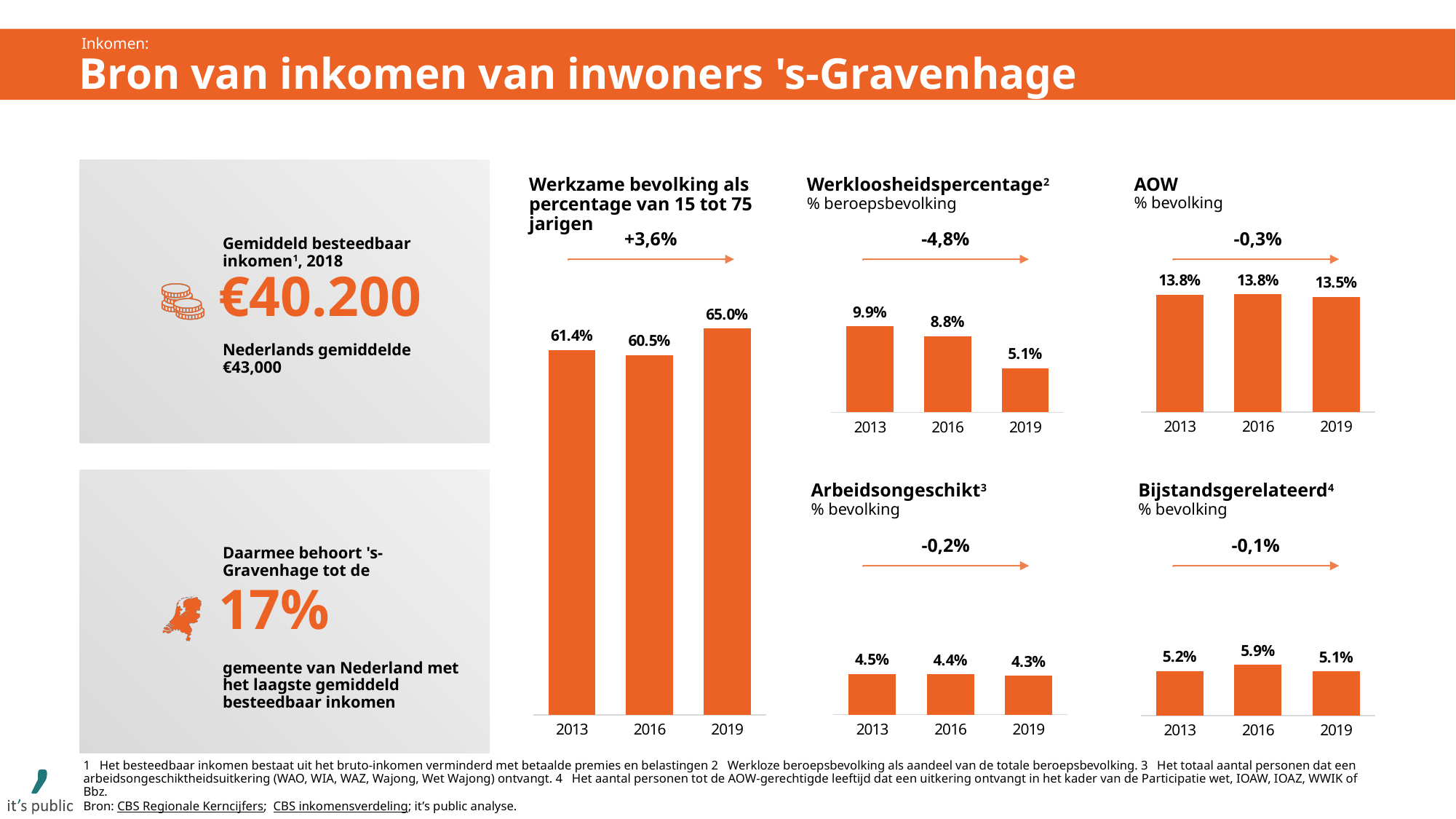
In the 'Bijstandsgerelateerd' chart, which year has the highest value? 2016 What kind of chart is the 'Bijstandsgerelateerd' chart? bar chart In the 'Werkzame bevolking als percentage van 15 tot 75 jarigen' chart, what is the value for 2019? 65.0% In the 'Werkloosheidspercentage' chart, what is the difference between the 2013 and 2019 values? 4.8 percentage points In the 'Werkloosheidspercentage' chart, do the values rise or fall from 2013 to 2019? fall In the 'AOW' chart, what is the value for 2019? 13.5% How many bar charts are shown on the slide? 5 In the 'Arbeidsongeschikt' chart, is the value for 2013 or 2019 larger? 2013 In the 'Bijstandsgerelateerd' chart, what is the difference between the 2016 and 2019 values? 0.8 percentage points How many years are shown on the x axis of the 'AOW' chart? 3 In the 'Werkzame bevolking als percentage van 15 tot 75 jarigen' chart, which year has the lowest value? 2016 In the 'Werkloosheidspercentage' chart, what is the value for 2013? 9.9%